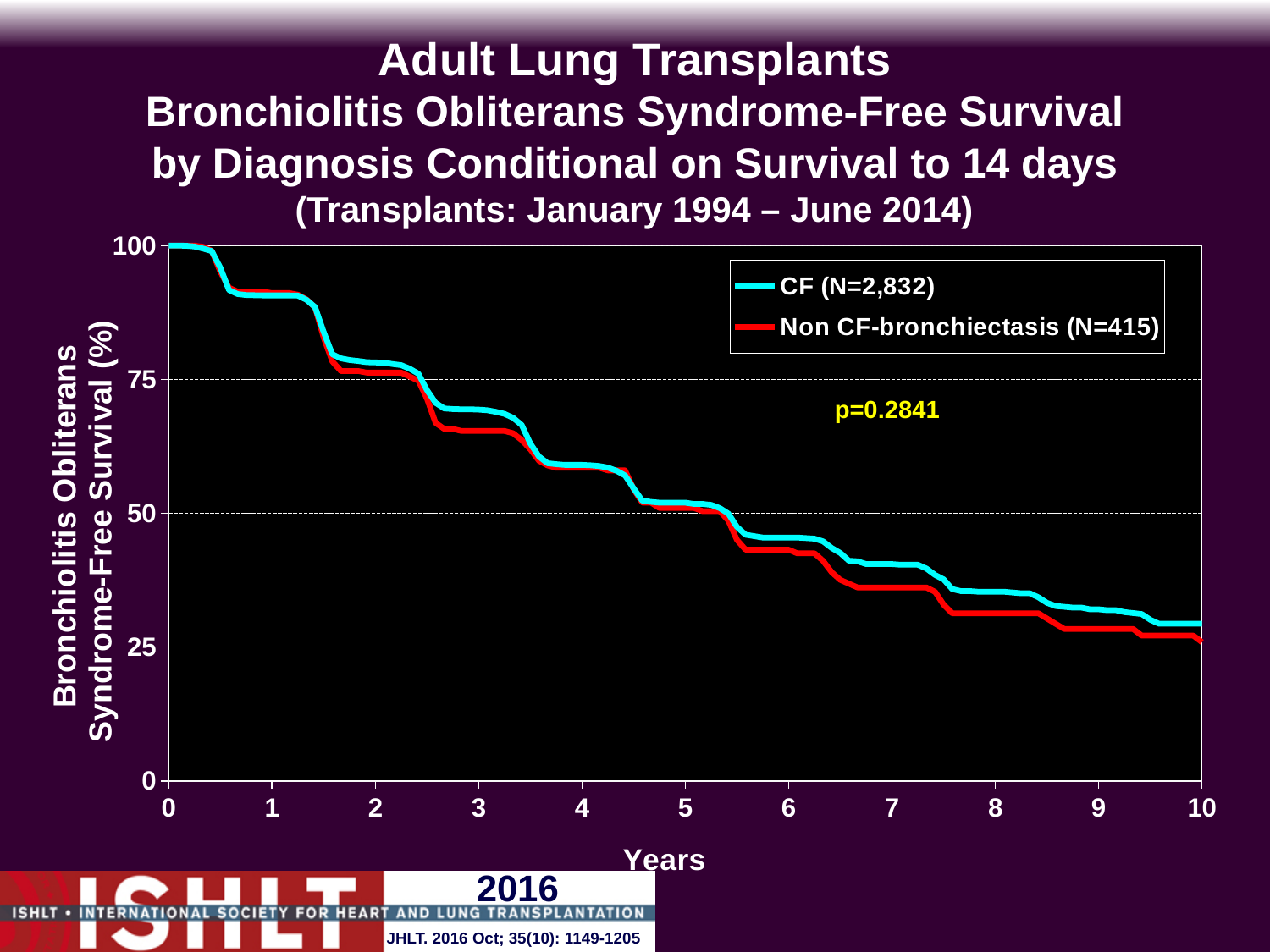
Is the value for CF at year 10 greater or less than 25? greater What p-value is shown on the chart? p=0.2841 At year 7, which series has the higher BOS-free survival, CF or Non CF-bronchiectasis? CF Is the value for Non CF-bronchiectasis at year 1 greater or less than 75? greater At year 9, which series has the lower BOS-free survival, CF or Non CF-bronchiectasis? Non CF-bronchiectasis Is the value for CF at year 2 greater or less than 75? greater What is the N for the CF series in the legend? N=2,832 How many series does the legend list? 2 What kind of chart is shown on the slide? Line chart Do the survival curves rise or fall as the years increase along the x axis? Fall